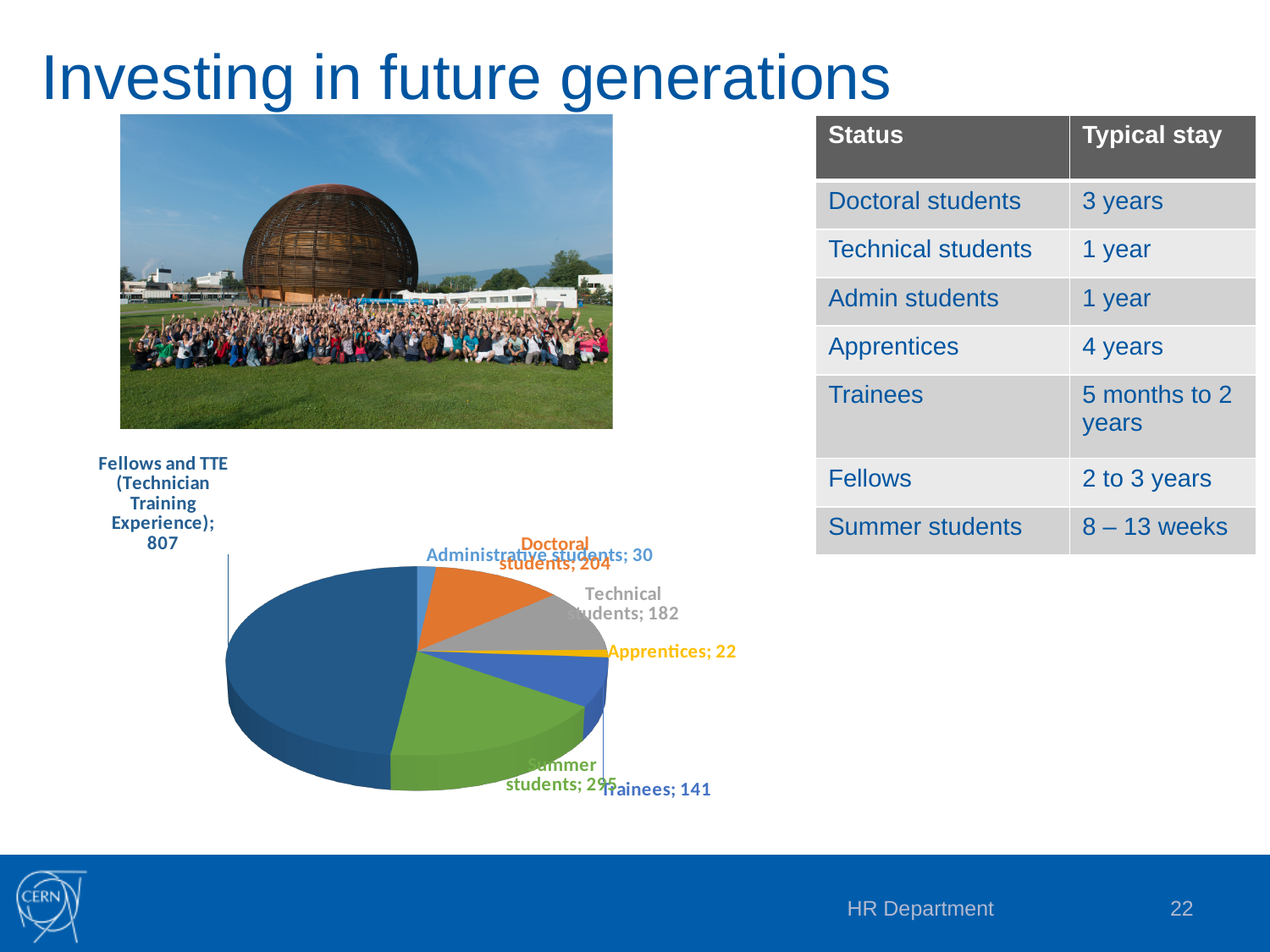
What is the value for Apprentices in the pie chart? 22 Which category has the largest slice in the pie chart? Fellows and TTE (Technician Training Experience) Which category has the smallest slice in the pie chart? Apprentices What is the value for Summer students in the pie chart? 295 Which is larger in the pie chart, Doctoral students or Technical students? Doctoral students How many categories does the pie chart show? 7 What is the value for Doctoral students in the pie chart? 204 What is the difference between the values for Administrative students and Apprentices in the pie chart? 8 What kind of chart is shown on the slide? Pie chart What is the value for Fellows and TTE (Technician Training Experience) in the pie chart? 807 What is the difference between the values for Summer students and Trainees in the pie chart? 154 What is the value for Trainees in the pie chart? 141